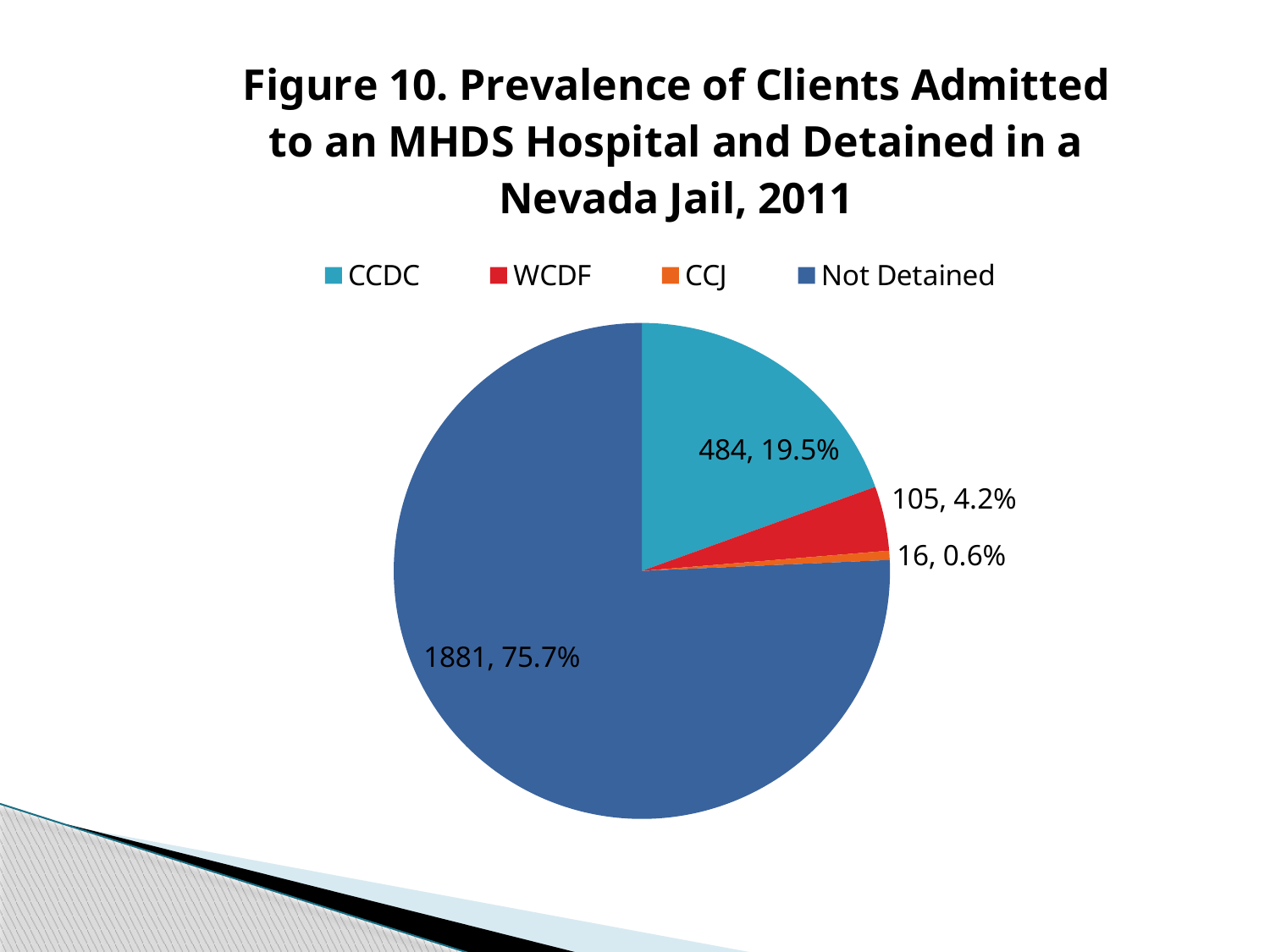
Which category has the smallest slice of the pie? CCJ How many clients are in the CCDC slice? 484 What is the value shown for the CCJ slice? 16 How many categories does the legend list? 4 What is the total number of clients across all four slices? 2486 What percentage of the pie does the WCDF slice represent? 4.2% What is the title of the chart? Figure 10. Prevalence of Clients Admitted to an MHDS Hospital and Detained in a Nevada Jail, 2011 What kind of chart is shown on the slide? pie chart Which is larger, the WCDF slice or the CCJ slice? WCDF What is the difference between the Not Detained count and the CCDC count? 1397 What percentage of the pie is the Not Detained slice? 75.7% Which category has the largest slice of the pie? Not Detained